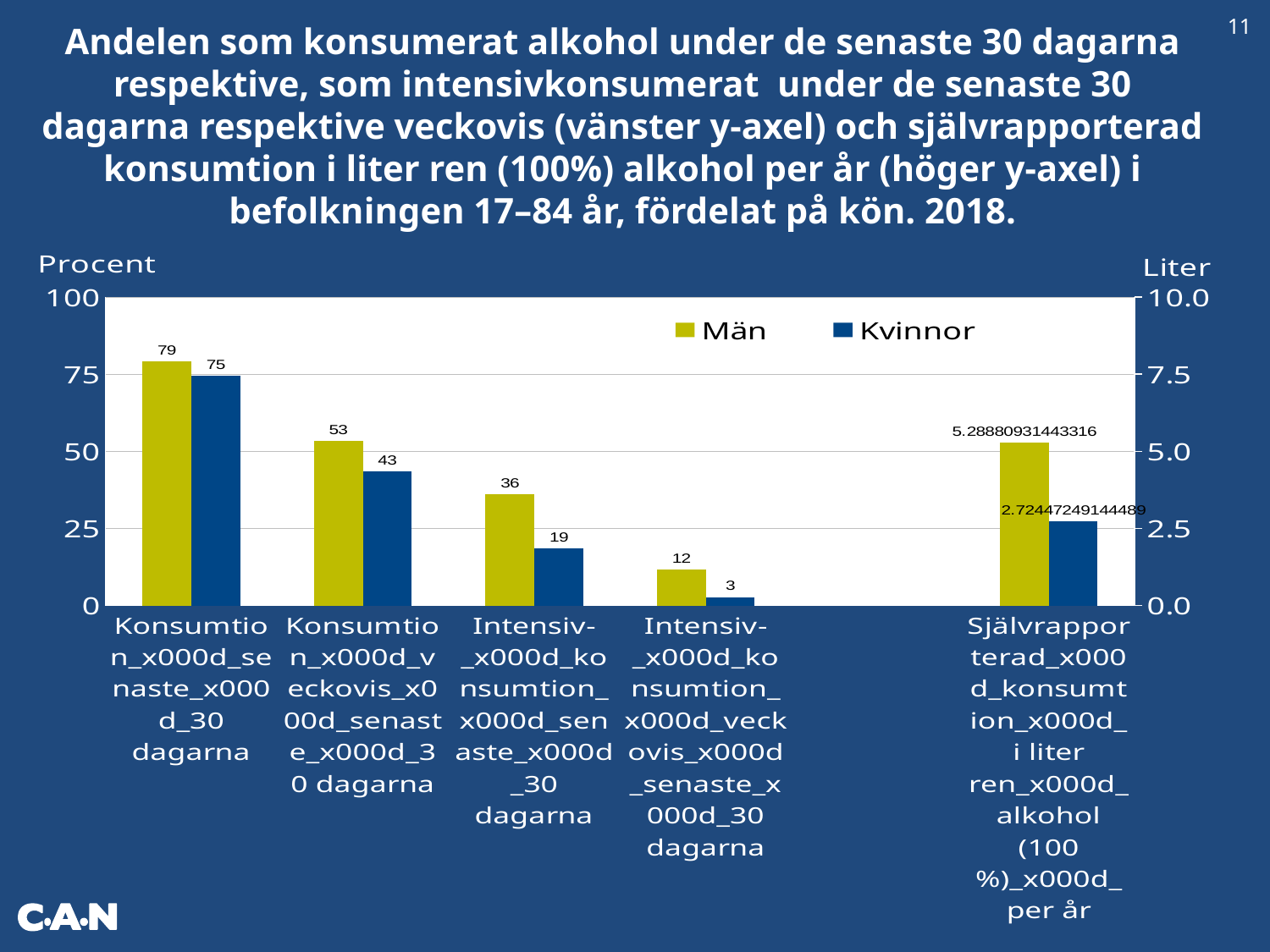
Which series is shown in blue in the legend? Kvinnor What is the value for Kvinnor in the category 'Konsumtion veckovis senaste 30 dagarna'? 43 What is the value for Kvinnor in the category 'Konsumtion senaste 30 dagarna'? 75 What is the value for Män in the category 'Konsumtion senaste 30 dagarna'? 79 In which category does the Män series reach its highest value? Konsumtion senaste 30 dagarna What is the value for Män in the category 'Intensivkonsumtion senaste 30 dagarna'? 36 What is the value for Män in the category 'Självrapporterad konsumtion i liter ren alkohol (100%) per år'? 5.28880931443316 What is the difference between the Män and Kvinnor values in the category 'Intensivkonsumtion senaste 30 dagarna'? 17 What is the value for Kvinnor in the category 'Intensivkonsumtion veckovis senaste 30 dagarna'? 3 What kind of chart is shown on the slide? bar chart Which series has the higher value in the category 'Konsumtion veckovis senaste 30 dagarna', Män or Kvinnor? Män How many series does the legend list? 2